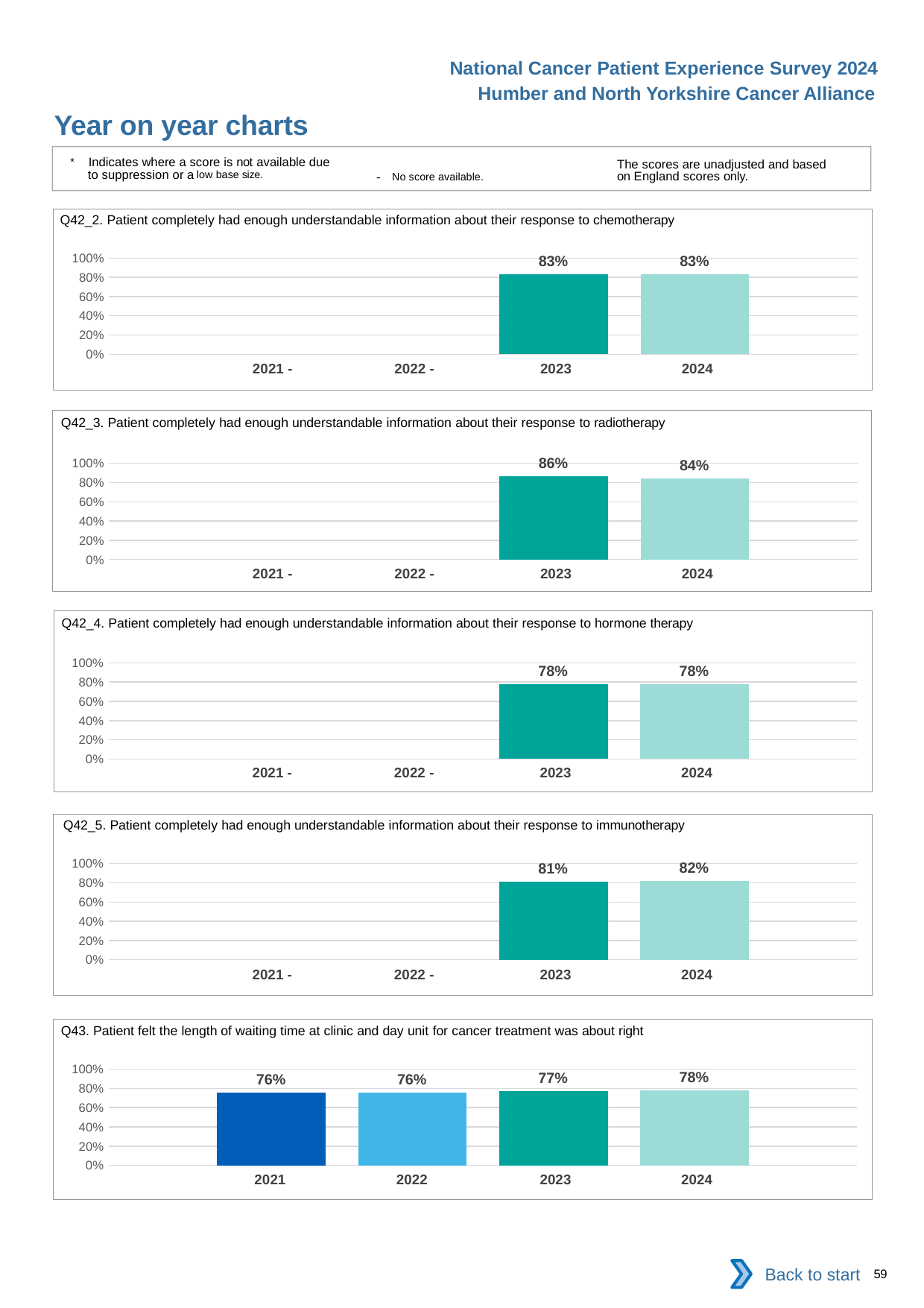
How many bars are plotted in the Q43 chart (waiting time at clinic and day unit)? 4 What type of chart is the Q42_2 chart (chemotherapy)? bar chart In the Q43 chart (waiting time at clinic and day unit), do the values rise or fall from 2021 to 2024? rise In the Q42_3 chart (radiotherapy), what is the difference between the 2023 and 2024 values? 2% In the Q43 chart (waiting time at clinic and day unit), what is the difference between the 2024 and 2021 values? 2% In the Q42_5 chart (immunotherapy), which year has the higher value, 2023 or 2024? 2024 In the Q42_3 chart (radiotherapy), what is the value for 2023? 86% In the Q43 chart (waiting time at clinic and day unit), which year has the highest value? 2024 In the Q42_5 chart (immunotherapy), what is the value for 2023? 81% In the Q43 chart (waiting time at clinic and day unit), what is the value for 2021? 76% In the Q42_2 chart (chemotherapy), what is the value for 2024? 83% In the Q42_4 chart (hormone therapy), what is the value for 2023? 78%